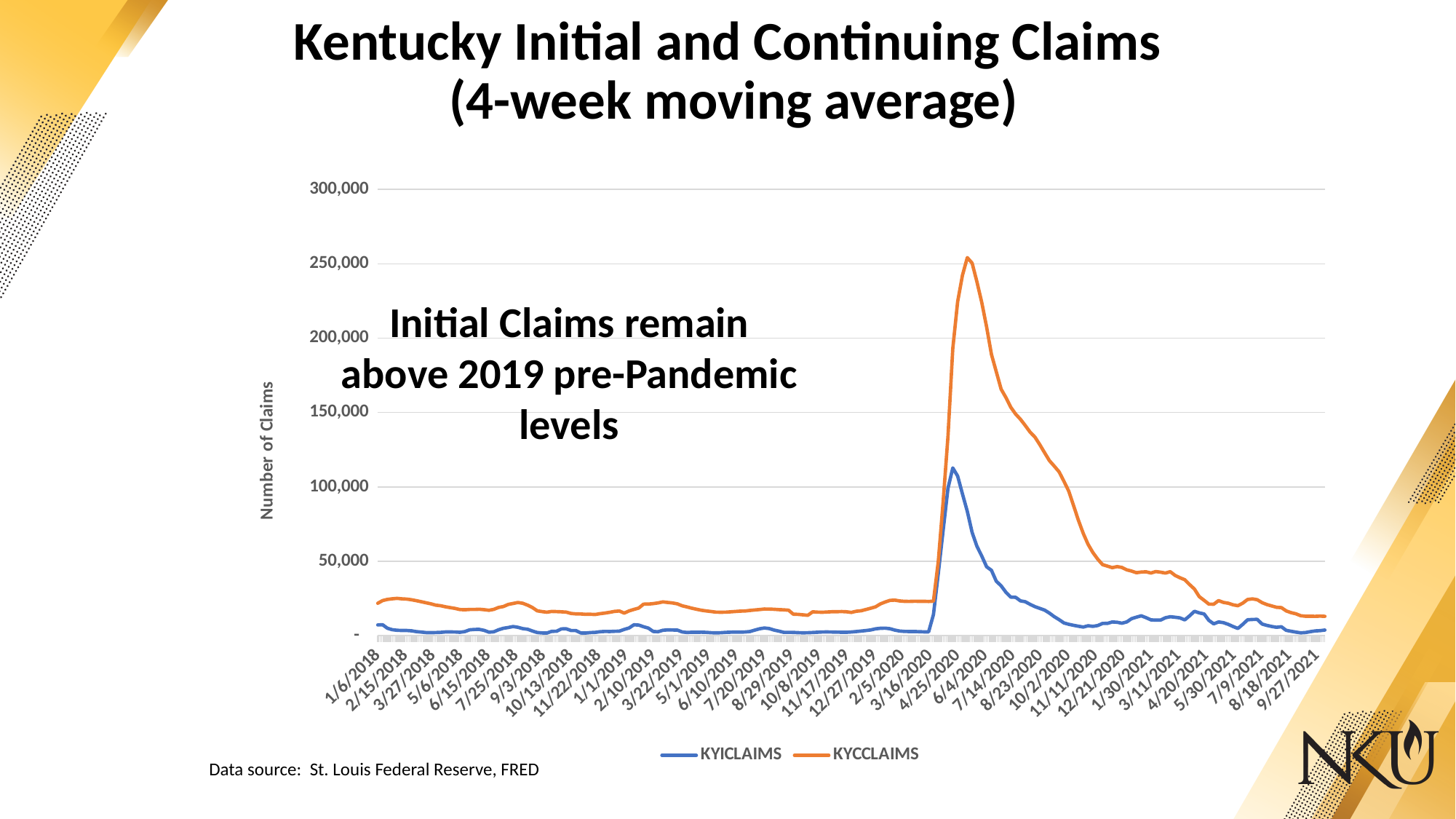
Is the value of KYCCLAIMS at 1/6/2018 greater or less than 50,000? less How many series does the legend list? 2 Is the peak value of KYCCLAIMS greater or less than 200,000? greater Which series reaches the highest value on the chart? KYCCLAIMS What is the label on the vertical axis? Number of Claims Is the peak value of KYICLAIMS greater or less than 100,000? greater What are the two series named in the legend? KYICLAIMS and KYCCLAIMS Which series is drawn in orange? KYCCLAIMS After peaking in 2020, do the KYCCLAIMS values rise or fall toward the end of the x axis? fall What kind of chart is shown on the slide? Line chart Around 6/4/2020, which series has the larger value, KYICLAIMS or KYCCLAIMS? KYCCLAIMS